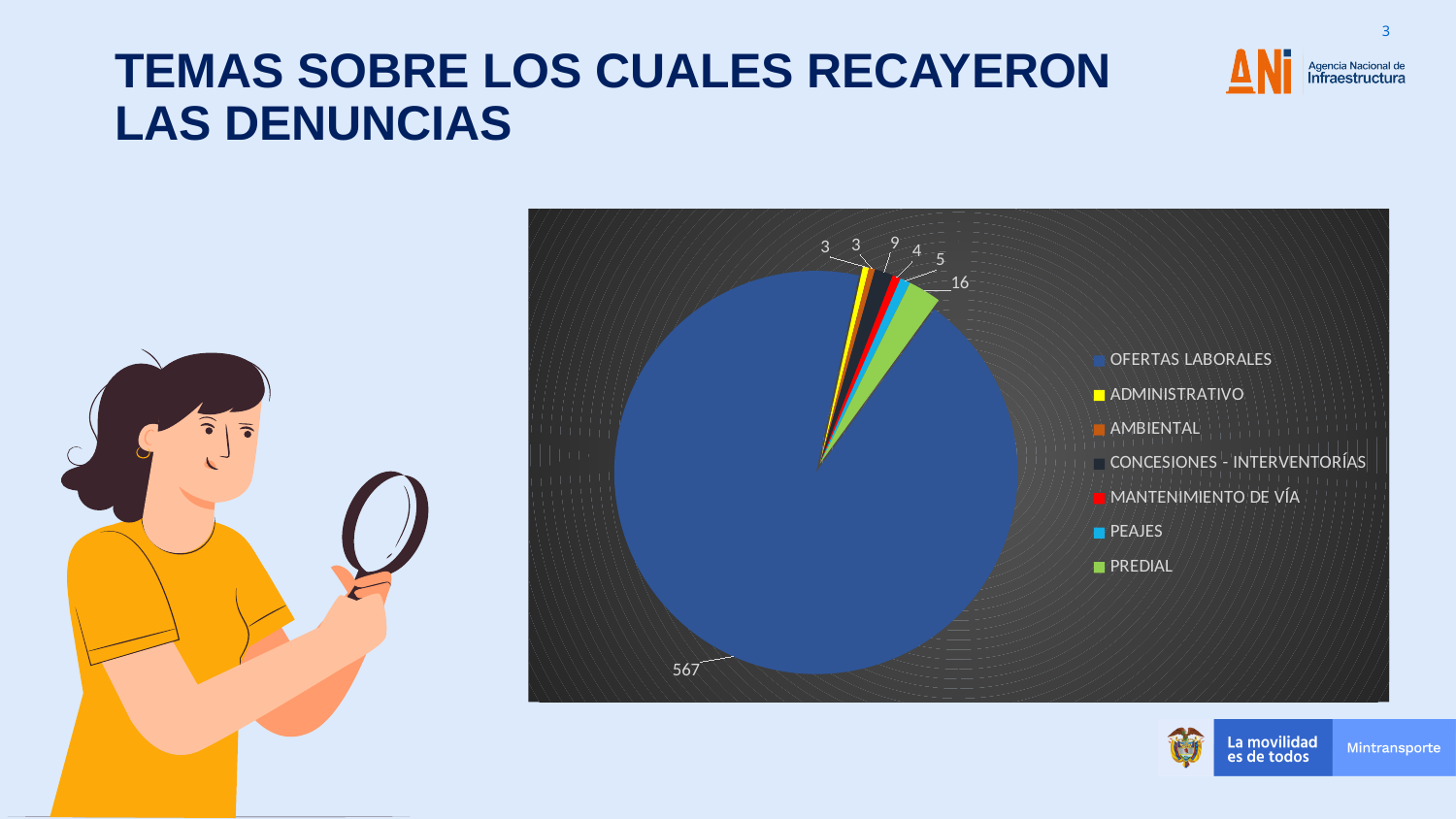
What is the value shown for MANTENIMIENTO DE VÍA? 4 What colour is the OFERTAS LABORALES slice in the pie chart? Blue What is the difference between the values for PREDIAL and CONCESIONES - INTERVENTORÍAS? 7 What is the value shown for PREDIAL? 16 What is the total of all the values shown on the pie chart? 607 What kind of chart is shown on the slide? Pie chart What is the value shown for PEAJES? 5 What is the value shown for CONCESIONES - INTERVENTORÍAS? 9 Which category has the largest slice of the pie chart? OFERTAS LABORALES Which is larger, the value for PEAJES or the value for MANTENIMIENTO DE VÍA? PEAJES What is the value shown for OFERTAS LABORALES? 567 How many categories does the pie chart's legend list? 7